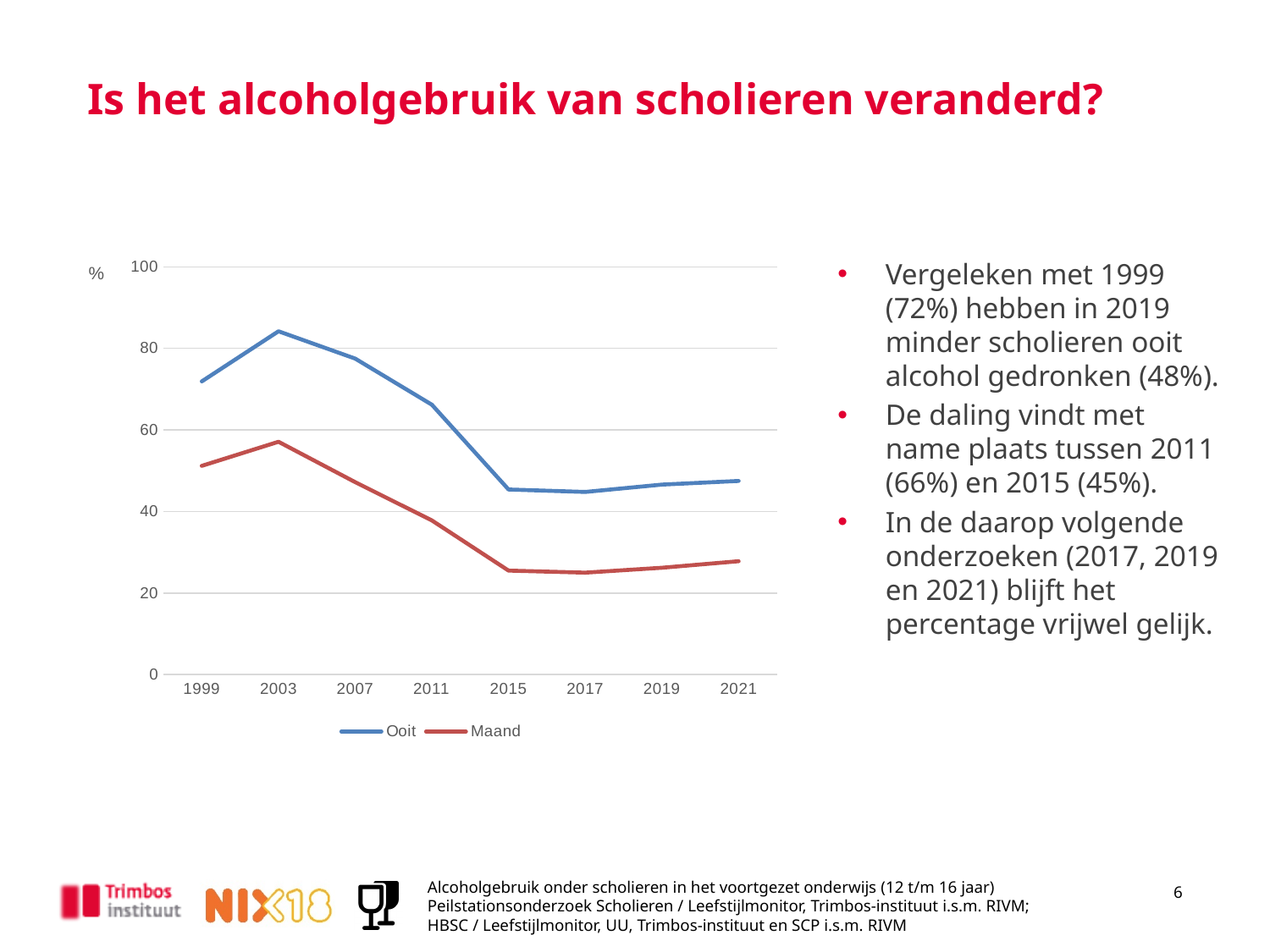
How many series does the legend list? 2 Is the value for Ooit in 2003 greater or less than 80? greater Is the value for Maand in 1999 greater or less than 40? greater Is the value for Maand in 2021 greater or less than 40? less Which series has the higher value in 2011, Ooit or Maand? Ooit In which year does the Ooit series reach its highest value? 2003 Does the Ooit series rise or fall between 2003 and 2015? fall What are the two series named in the legend? Ooit and Maand How many years are shown on the x axis? 8 In which year does the Maand series reach its highest value? 2003 What kind of chart is shown on the slide? line chart